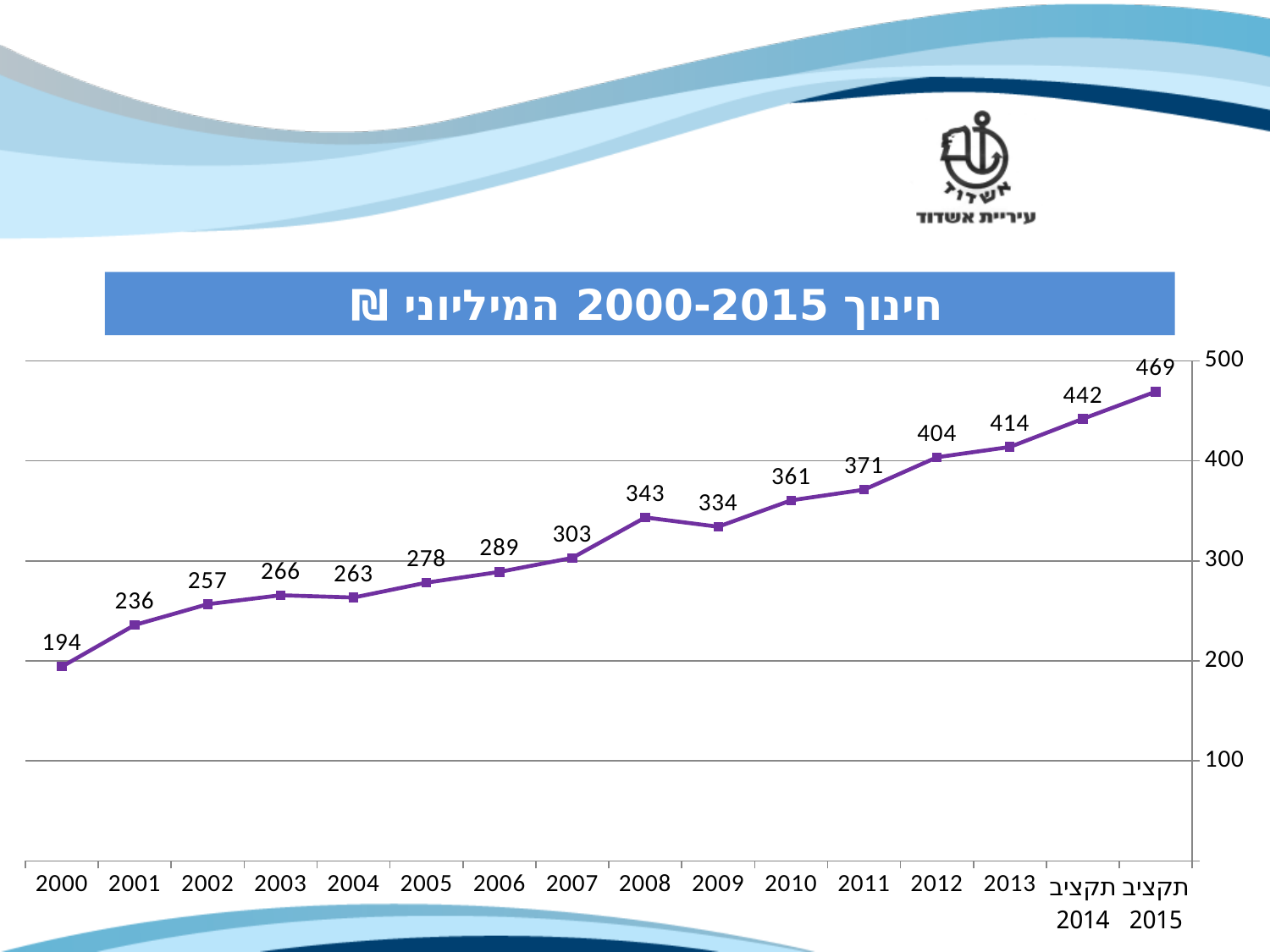
What is the difference between the values for 2012 and 2011? 33 Is the value for 2007 greater or less than 300? greater Which is larger, the value for 2008 or the value for 2009? 2008 Do the values generally rise or fall from 2000 to תקציב 2015? rise Which year has the lowest value? 2000 Which category has the highest value? תקציב 2015 What is the value for תקציב 2015? 469 What is the title of the chart? חינוך 2000-2015 המיליוני ₪ What type of chart is shown on the slide? line chart What is the value for 2000? 194 How many data points are plotted on the chart? 16 What is the value for 2008? 343